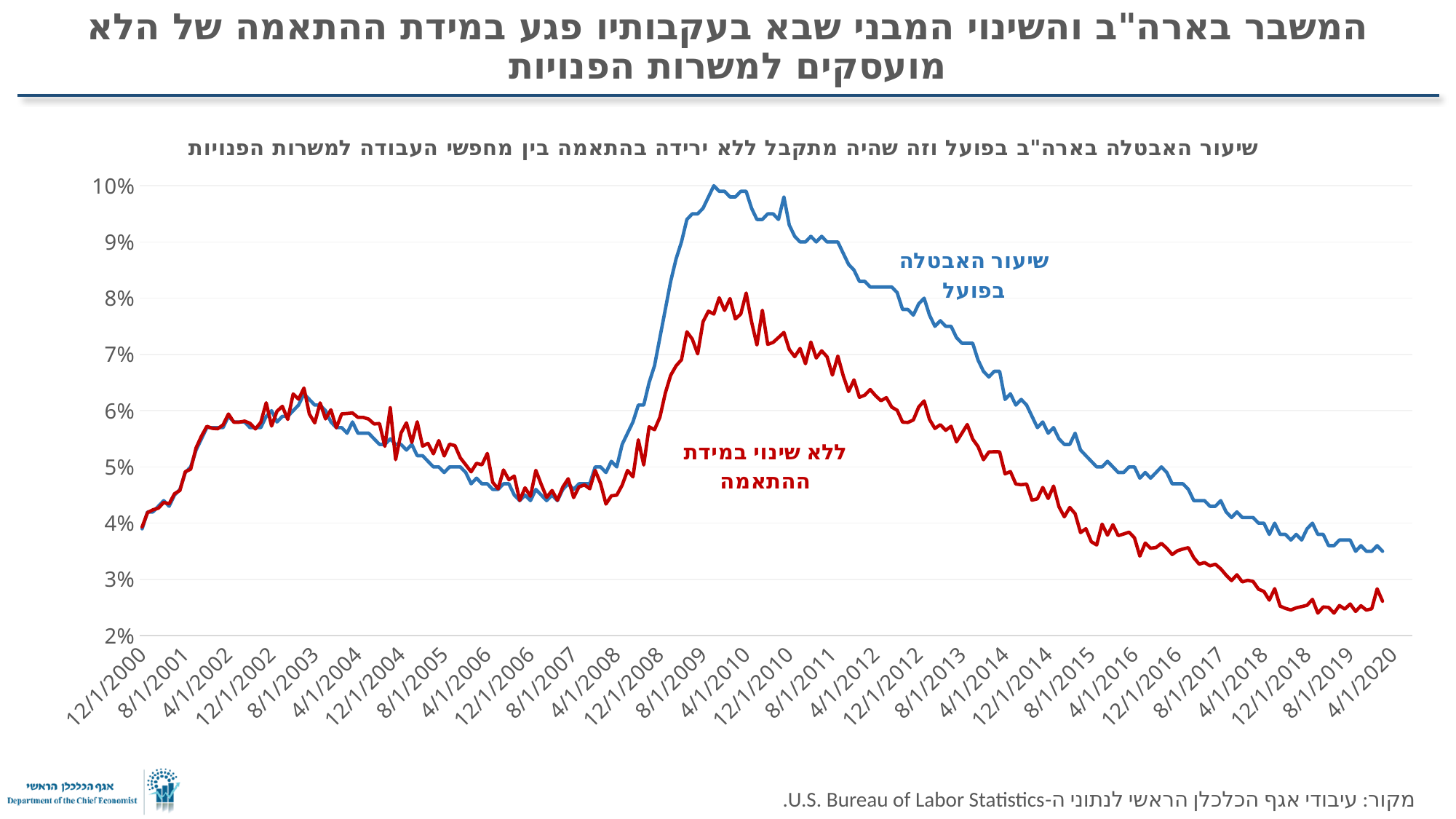
Which series reaches the lowest value on the chart? ללא שינוי במידת ההתאמה How many data series are plotted on the chart? 2 Which series reaches the highest value on the chart? שיעור האבטלה בפועל What colour is the line for שיעור האבטלה בפועל? blue What kind of chart is shown on the slide? line chart At 4/1/2010, which series has the higher value: שיעור האבטלה בפועל or ללא שינוי במידת ההתאמה? שיעור האבטלה בפועל Is the value of שיעור האבטלה בפועל at 12/1/2012 greater or less than 7%? greater Is the value of ללא שינוי במידת ההתאמה at 12/1/2018 greater or less than 3%? less Is the value of שיעור האבטלה בפועל at 8/1/2009 greater or less than 9%? greater Does the ללא שינוי במידת ההתאמה series rise or fall between 12/1/2007 and 4/1/2010? rise